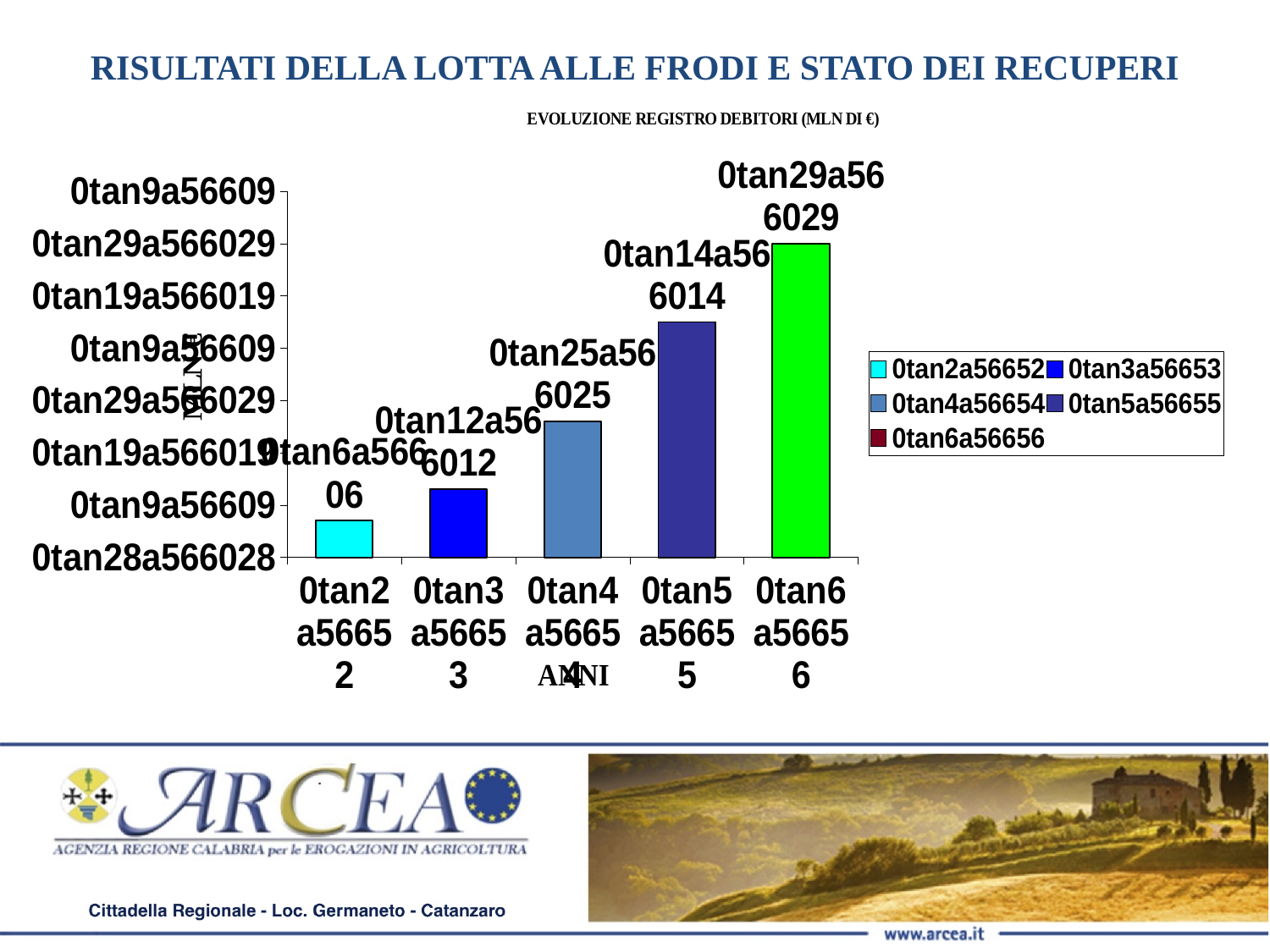
Which bar is the tallest in the chart, by position? the rightmost bar Do the bar values rise or fall from left to right along the x axis? rise What colour is the tallest bar in the chart? green Is the second bar from the left taller or shorter than the rightmost bar? shorter What kind of chart is shown on the slide? bar chart What is the label of the x axis of the chart? ANNI Which bar is the shortest in the chart, by position? the leftmost bar Is the fourth bar from the left taller or shorter than the third bar from the left? taller What is the title of the chart? EVOLUZIONE REGISTRO DEBITORI (MLN DI €) How many bars are plotted in the chart? 5 How many entries does the chart's legend list? 5